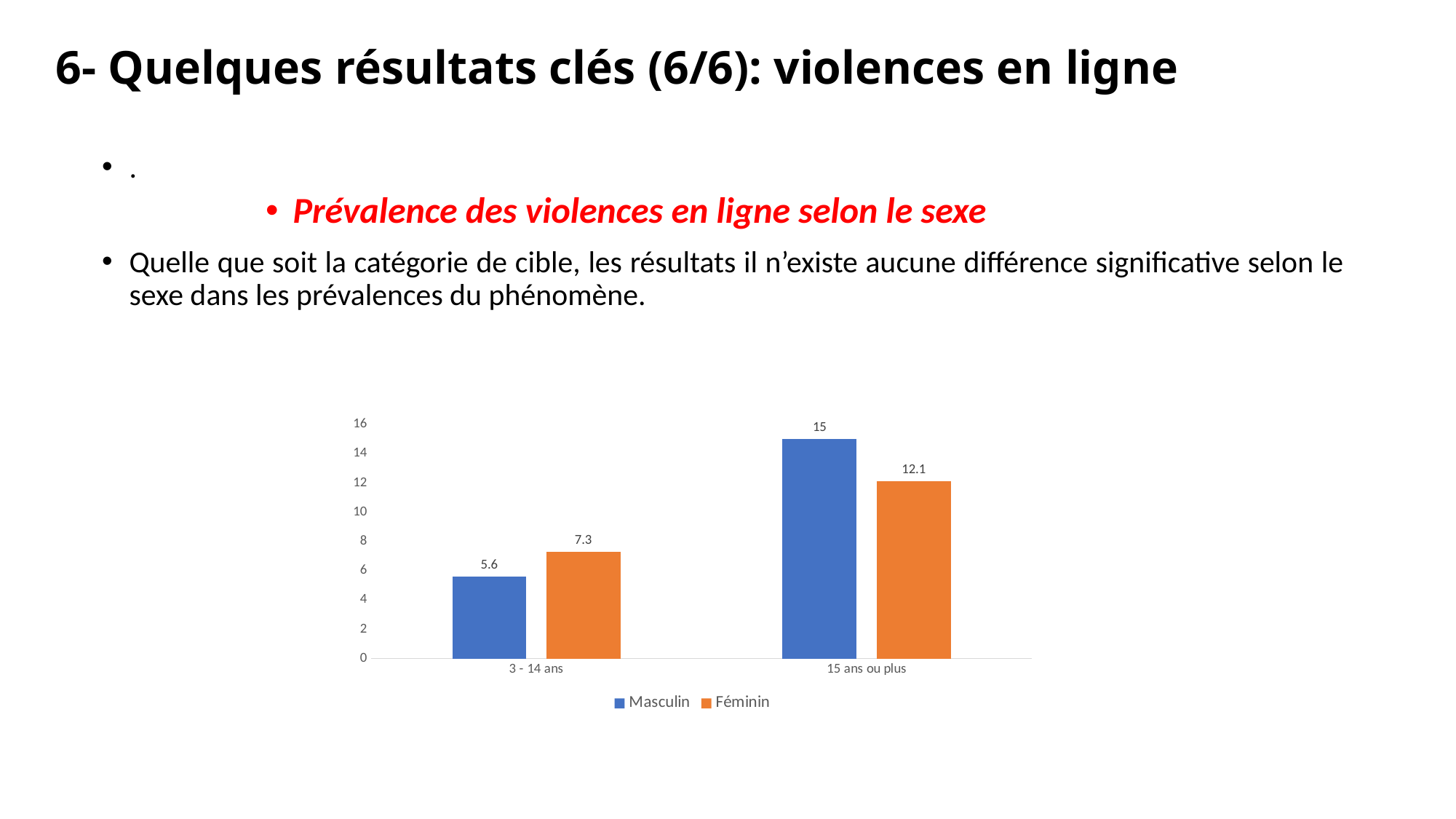
What is the value for Masculin in the 3 - 14 ans category? 5.6 How many categories are shown on the x axis? 2 What is the value for Féminin in the 15 ans ou plus category? 12.1 What is the difference between the Masculin and Féminin values in the 15 ans ou plus category? 2.9 How many series does the legend list? 2 Is the Masculin value for 15 ans ou plus greater or less than 14? greater What is the value for Féminin in the 3 - 14 ans category? 7.3 What is the value for Masculin in the 15 ans ou plus category? 15 What kind of chart is shown on the slide? Bar chart In the 3 - 14 ans category, which is larger: Masculin or Féminin? Féminin Which category has the highest Masculin value? 15 ans ou plus Which category has the lowest Féminin value? 3 - 14 ans